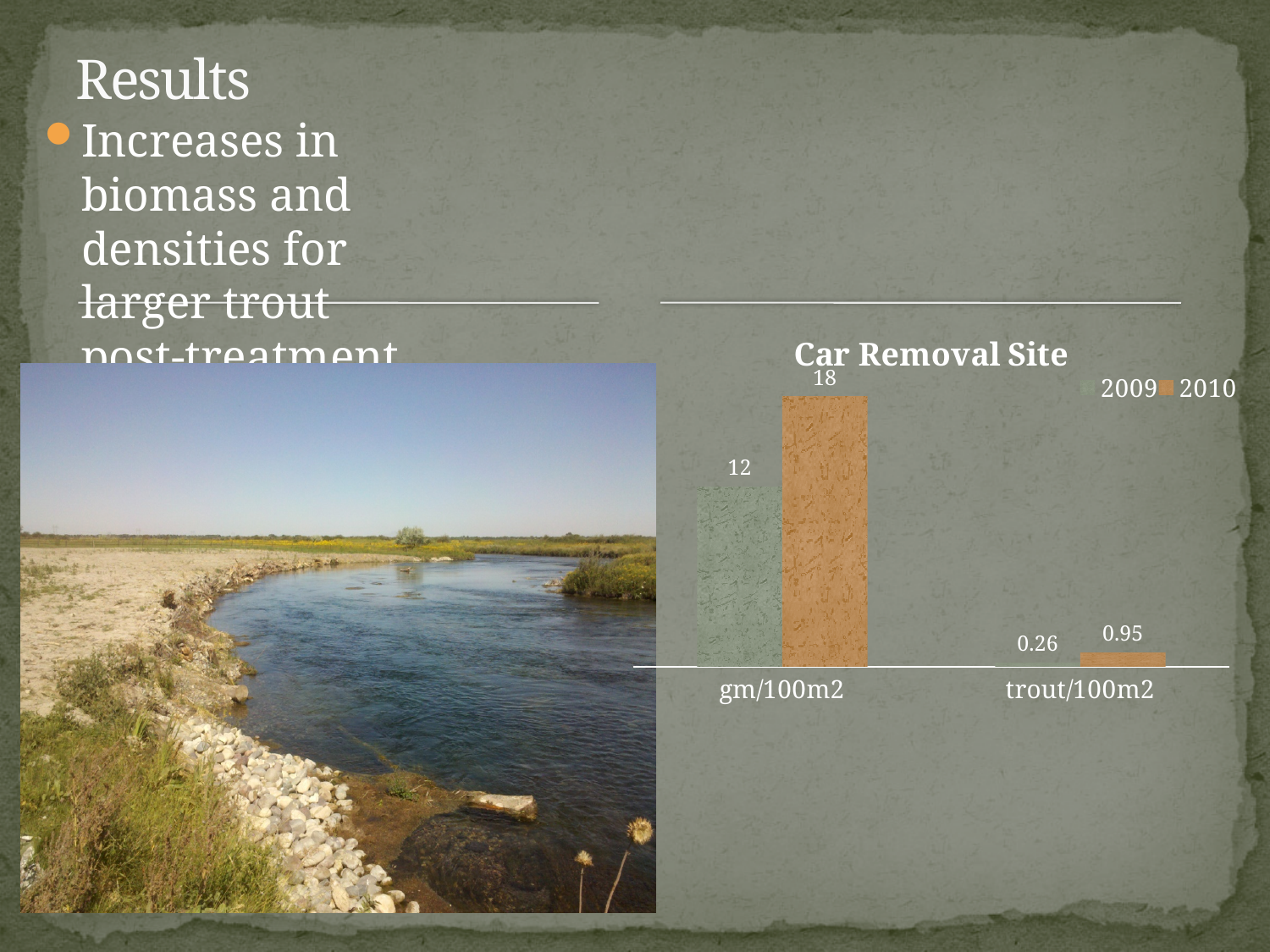
What is the difference between the 2010 and 2009 values for gm/100m2? 6 What is the title of the chart? Car Removal Site Which year has the larger value for trout/100m2, 2009 or 2010? 2010 What is the 2009 value for trout/100m2? 0.26 What type of chart is shown on the slide? bar chart What are the series names in the legend? 2009 and 2010 Which bar has the highest value in the chart? 2010 gm/100m2 How many categories are shown on the x axis? 2 What is the 2010 value for trout/100m2? 0.95 How many series does the legend list? 2 What is the 2010 value for gm/100m2? 18 What is the 2009 value for gm/100m2? 12